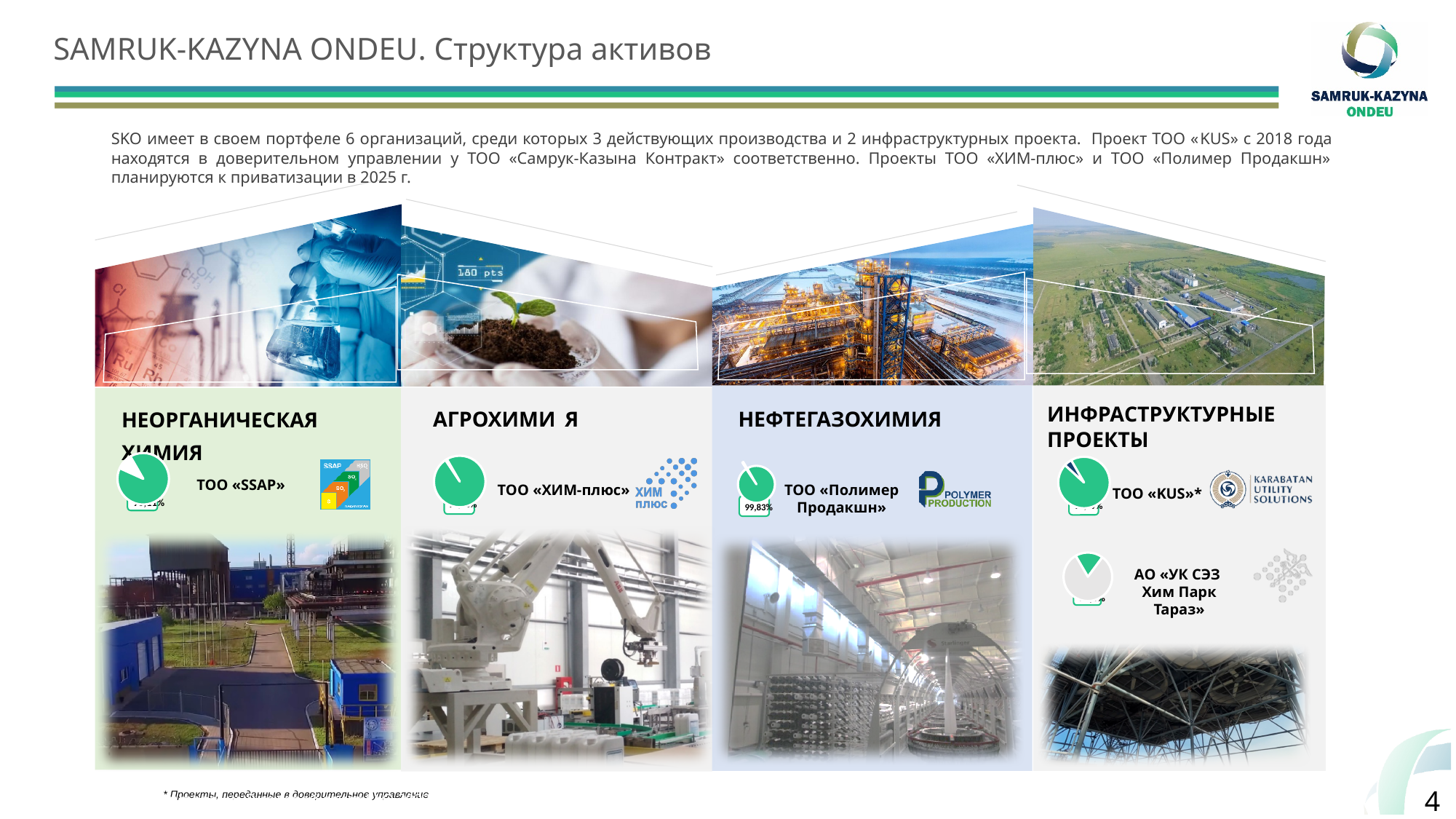
Which pie chart shows a larger green share: ТОО «KUS» or АО «УК СЭЗ Хим Парк Тараз»? ТОО «KUS» What value is shown on the pie chart for ТОО «Полимер Продакшн»? 99,83% Which company's pie chart has the smallest green share? АО «УК СЭЗ Хим Парк Тараз» Which company's pie chart is shown in the «Агрохимия» column? ТОО «ХИМ-плюс» How many pie charts are shown on the slide? 5 What kind of chart is used next to each company name on the slide? Pie chart How many pie charts are shown in the «Инфраструктурные проекты» column? 2 Which company's pie chart is shown in the «Нефтегазохимия» column? ТОО «Полимер Продакшн» Which pie chart shows a larger green share: ТОО «Полимер Продакшн» or АО «УК СЭЗ Хим Парк Тараз»? ТОО «Полимер Продакшн»